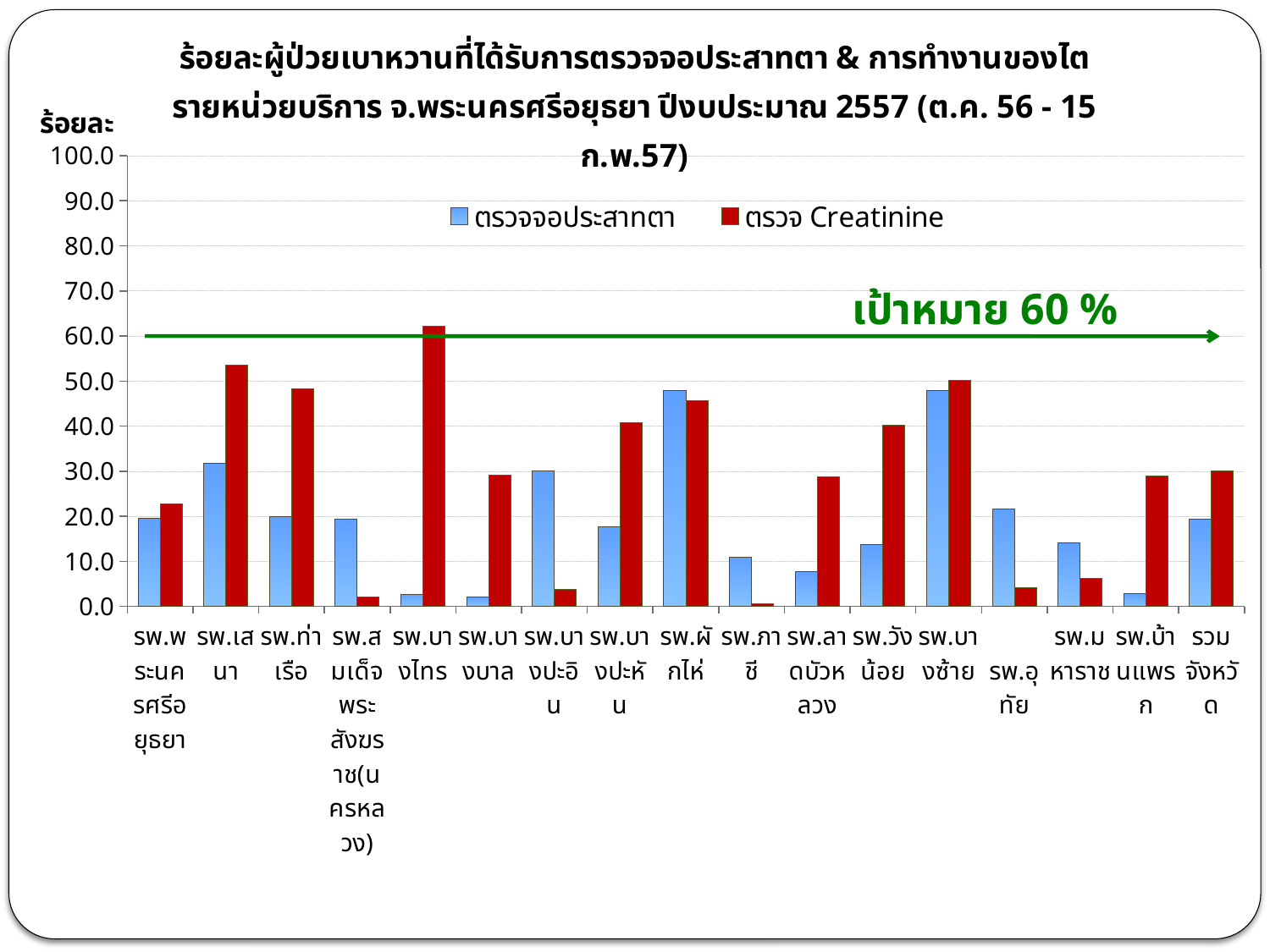
Is the ตรวจ Creatinine value for รพ.บางไทร greater or less than 50? greater For รพ.ท่าเรือ, which series has the larger value, ตรวจจอประสาทตา or ตรวจ Creatinine? ตรวจ Creatinine How many hospital/unit categories are shown on the x axis? 17 Which category has the lowest value for ตรวจ Creatinine? รพ.ภาชี For รพ.สมเด็จพระสังฆราช(นครหลวง), which series has the larger value, ตรวจจอประสาทตา or ตรวจ Creatinine? ตรวจจอประสาทตา How many series does the legend list? 2 What kind of chart is shown on the slide? bar chart Is the ตรวจจอประสาทตา value for รพ.ภาชี greater or less than 20? less Which category has the highest value for ตรวจ Creatinine? รพ.บางไทร Is the ตรวจ Creatinine value for รพ.สมเด็จพระสังฆราช(นครหลวง) greater or less than 10? less What target percentage is marked by the green line on the chart? 60 %